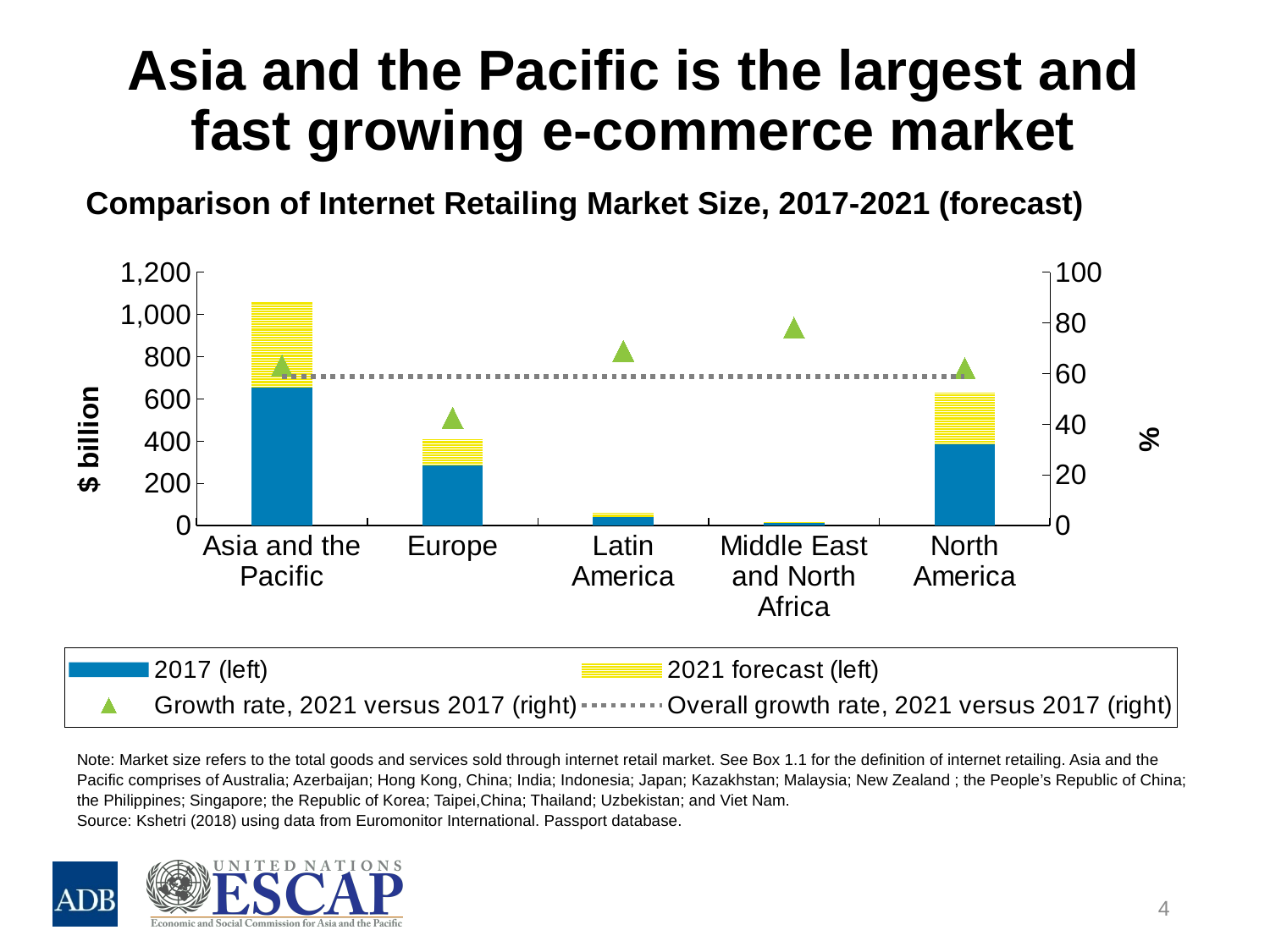
Is the growth rate for the Middle East and North Africa greater or less than 60%? greater Which region has the highest growth rate, 2021 versus 2017? Middle East and North Africa Which region has the smallest 2017 internet retailing market size? Middle East and North Africa Which has the larger 2017 market size, Europe or North America? North America What kind of chart is shown on the slide? combination bar and line chart What unit is shown on the left vertical axis of the chart? $ billion Which region has the lowest growth rate, 2021 versus 2017? Europe How many regions are shown on the x axis of the chart? 5 Is the 2017 market size for Asia and the Pacific greater or less than 400 $ billion? greater Is the 2017 market size for Europe greater or less than 400 $ billion? less How many series does the chart's legend list? 4 Which region has the largest 2017 internet retailing market size? Asia and the Pacific